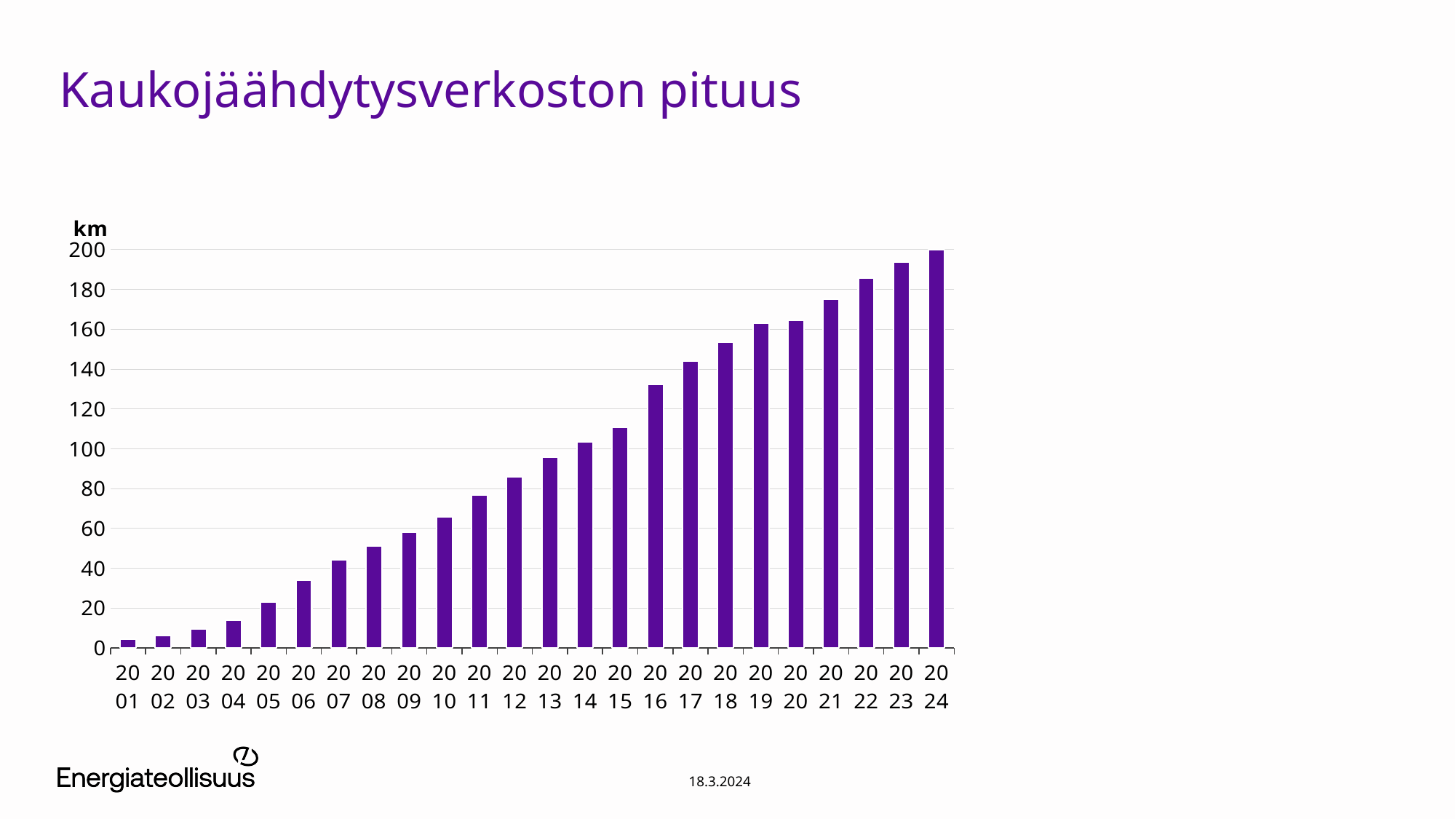
Is the value for 2010 greater or less than 80? less What is the title of the chart on the slide? Kaukojäähdytysverkoston pituus Do the values rise or fall from 2001 to 2024? rise Is the value for 2022 greater or less than 180? greater How many years (bars) are shown in the chart? 24 What kind of chart is shown on the slide? bar chart Is the value for 2005 greater or less than 40? less Which year has the highest value in the chart? 2024 Which year has the lowest value in the chart? 2001 Which is larger, the value for 2013 or the value for 2018? 2018 What unit is shown on the vertical axis of the chart? km